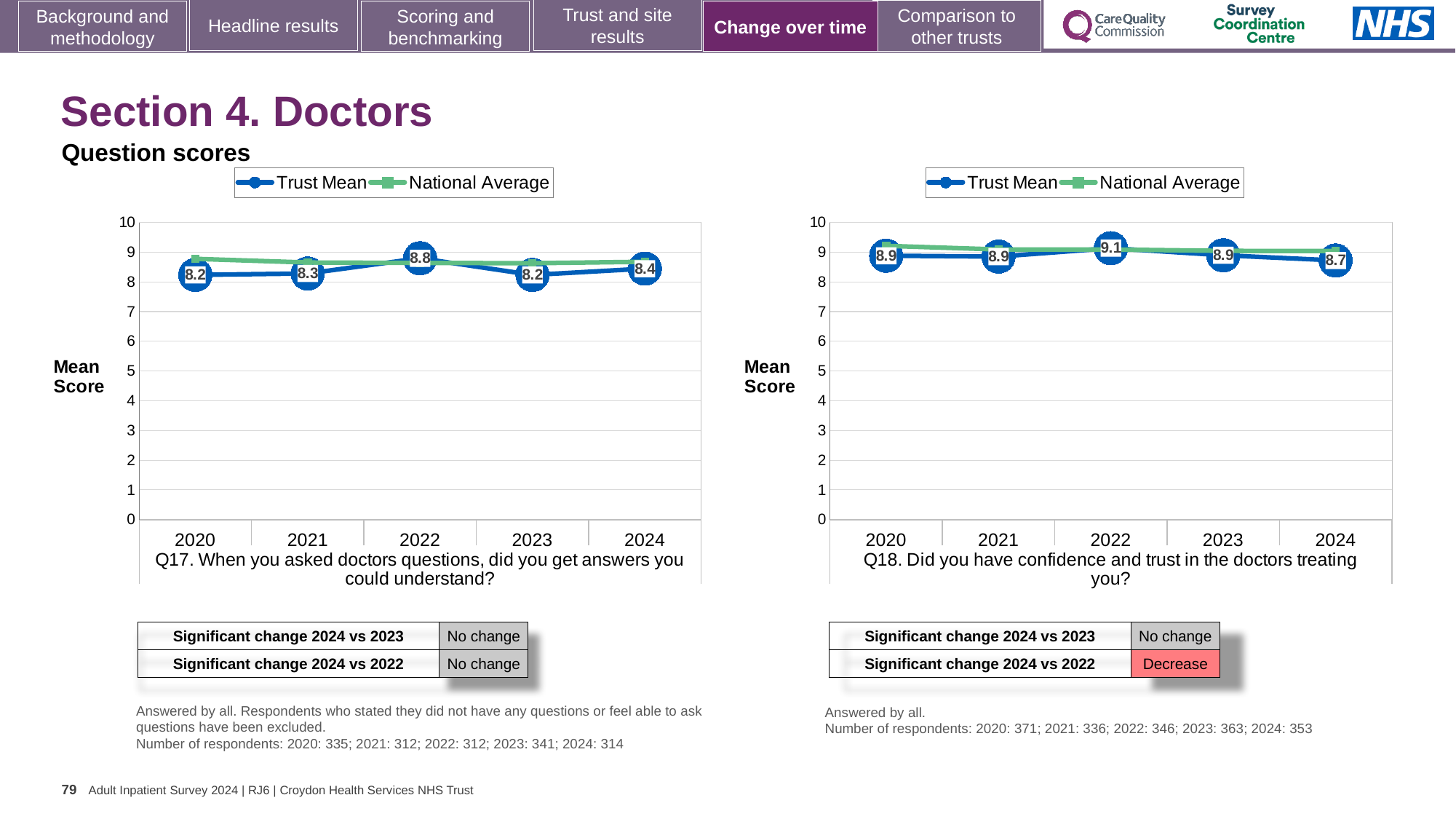
What type of chart is the Q17 chart (left)? Line chart On the Q18 chart (right), what is the Trust Mean score for 2024? 8.7 On the Q17 chart (left), how many years are plotted on the x axis? 5 On the Q18 chart (right), what is the Trust Mean score for 2022? 9.1 On the Q18 chart (right), is the Trust Mean score for 2020 greater or less than 8? greater On the Q17 chart (left), what is the difference between the Trust Mean scores for 2022 and 2023? 0.6 How many series does the legend of the Q18 chart (right) list? 2 On the Q17 chart (left), what is the Trust Mean score for 2024? 8.4 Which is larger: the Trust Mean score for 2024 on the Q17 chart or the Trust Mean score for 2024 on the Q18 chart? Q18 chart (8.7) On the Q17 chart (left), which year has the highest Trust Mean score? 2022 On the Q17 chart (left), what is the Trust Mean score for 2022? 8.8 On the Q18 chart (right), which year has the lowest Trust Mean score? 2024